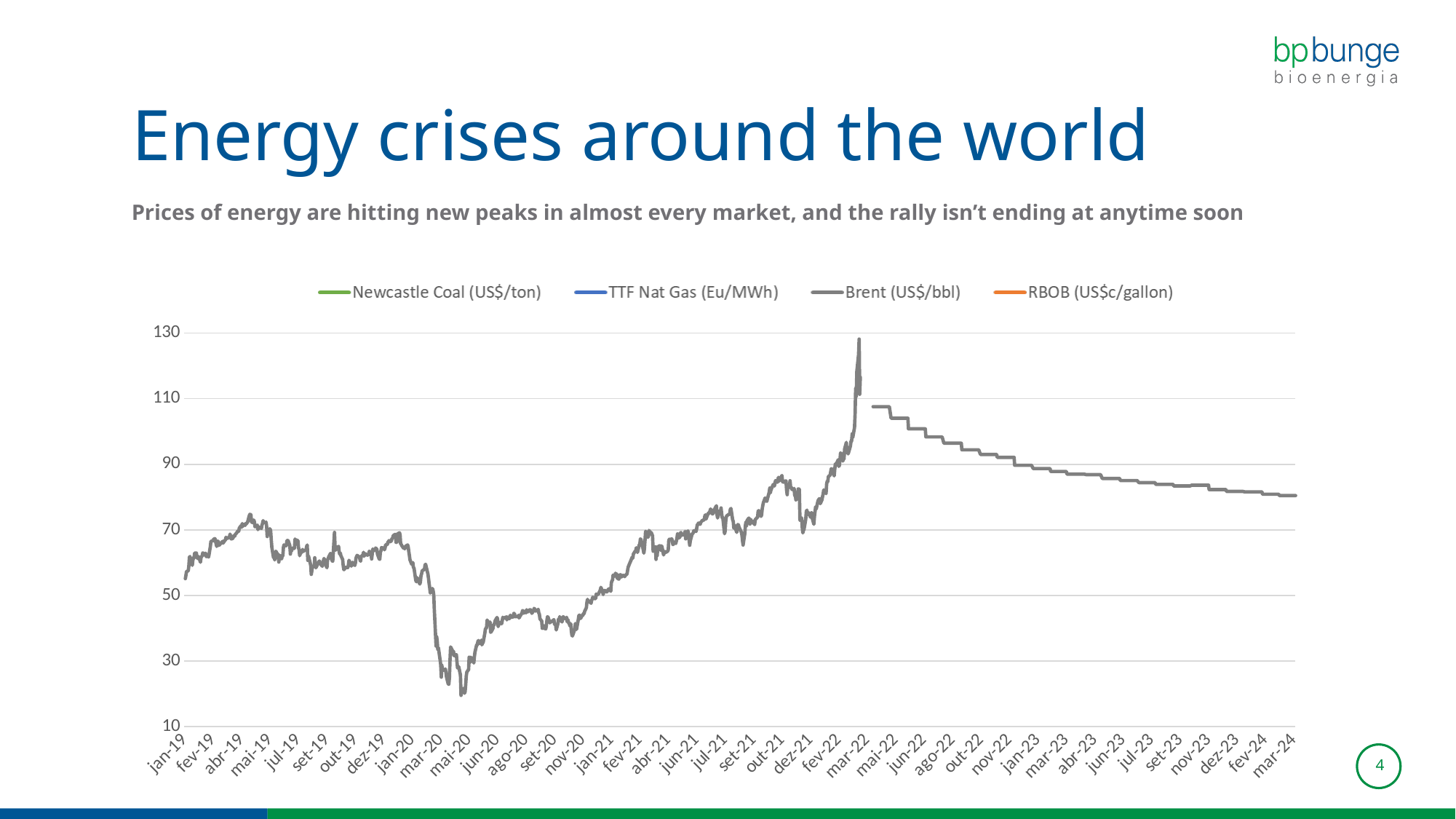
What kind of chart is shown on the slide? line chart How many series does the chart legend list? 4 Is the value of the Brent line at mar-24 greater or less than 90? less Is the peak value of the Brent line around mar-22 greater or less than 110? greater Is the value of the Brent line around mai-22 greater or less than 90? greater Does the Brent line rise or fall between mar-22 and mar-24? fall What is the title of the slide containing the chart? Energy crises around the world Which series is plotted in grey on the chart? Brent (US$/bbl) Around which x-axis label does the Brent line reach its highest point? mar-22 Around which x-axis label does the Brent line reach its lowest point? mai-20